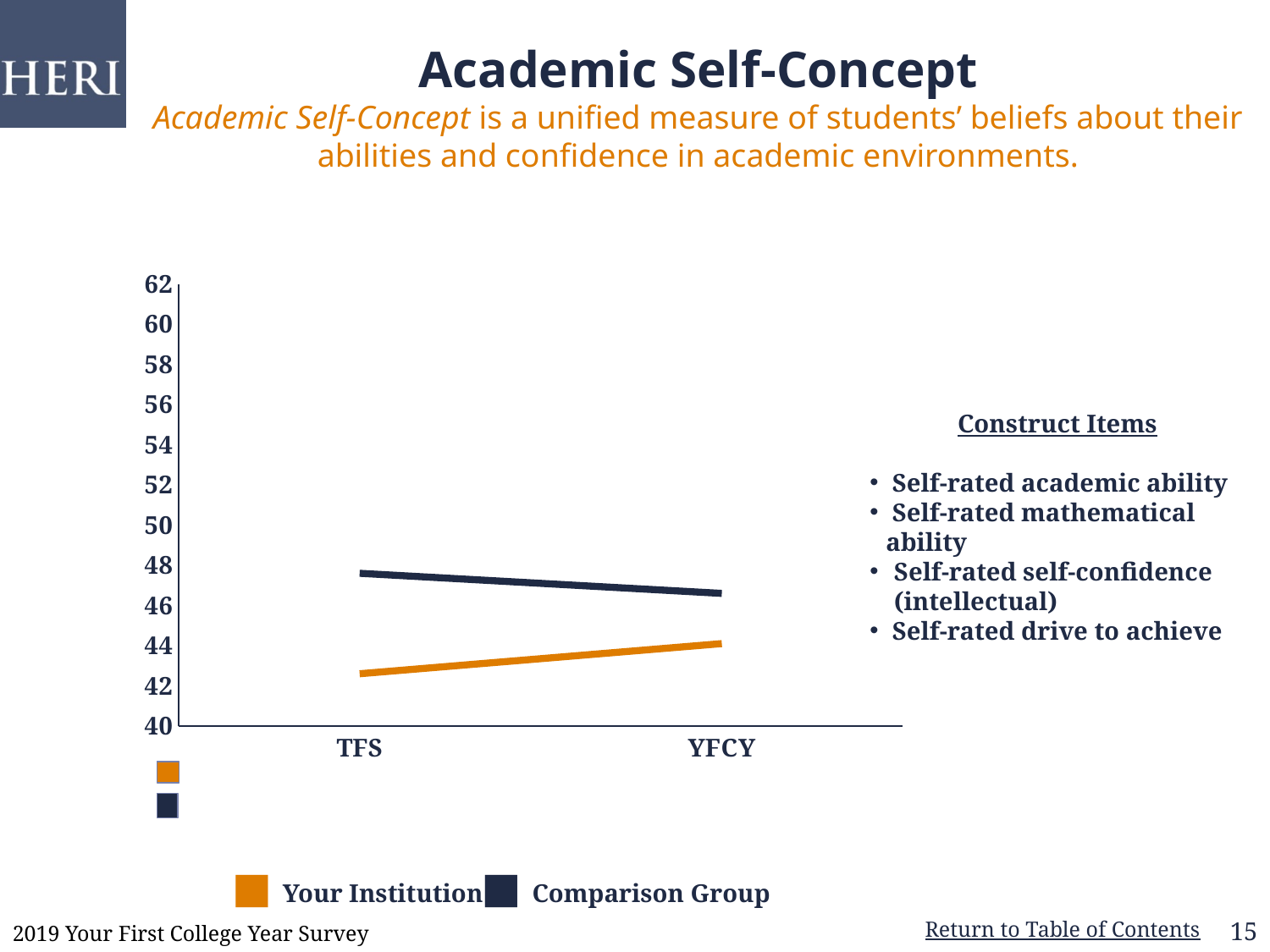
Is the value for Your Institution at YFCY greater or less than 42? greater Is the value for Comparison Group at TFS greater or less than 50? less Is the value for Your Institution at TFS greater or less than 44? less At TFS, which series has the higher value, Your Institution or Comparison Group? Comparison Group At YFCY, which series has the higher value, Your Institution or Comparison Group? Comparison Group Does the Your Institution line rise or fall from TFS to YFCY? rise What colour is the Your Institution line in the chart? orange What kind of chart is shown on the slide? line chart Does the Comparison Group line rise or fall from TFS to YFCY? fall How many points are on the x axis of the chart? 2 How many series does the legend list? 2